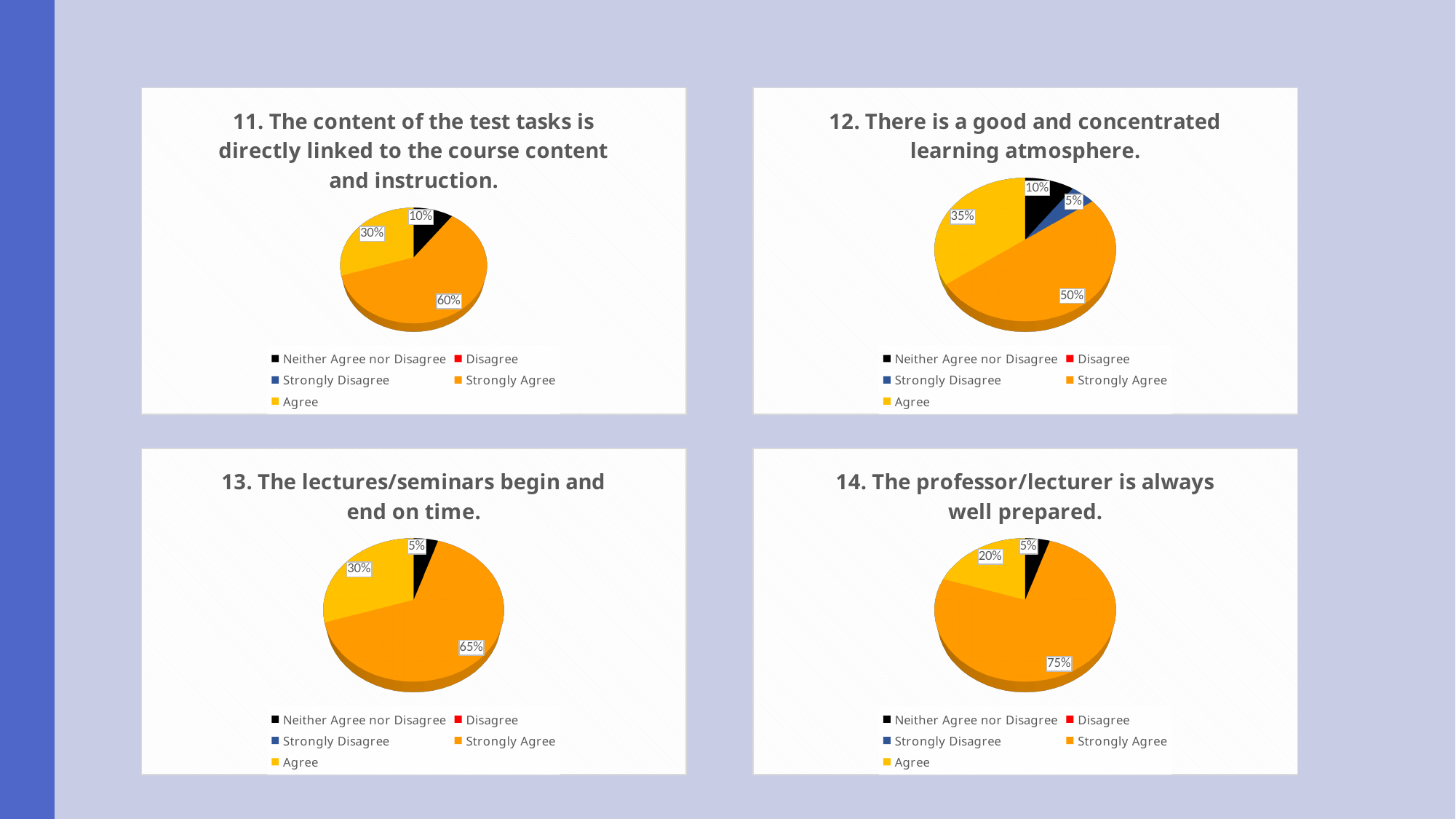
In the chart titled "14. The professor/lecturer is always well prepared.", is the Strongly Agree share larger or the Agree share larger? Strongly Agree What kind of chart is used for "13. The lectures/seminars begin and end on time."? Pie chart In the chart titled "12. There is a good and concentrated learning atmosphere.", what share of responses is Strongly Disagree? 5% In the chart titled "13. The lectures/seminars begin and end on time.", what share of responses is Strongly Agree? 65% In the chart titled "12. There is a good and concentrated learning atmosphere.", which response category has the largest share? Strongly Agree In the chart titled "12. There is a good and concentrated learning atmosphere.", how many slices have a data label shown? 4 In the chart titled "12. There is a good and concentrated learning atmosphere.", what is the difference between the Strongly Agree share and the Agree share? 15% In the chart titled "11. The content of the test tasks is directly linked to the course content and instruction.", what share of responses is Strongly Agree? 60% In the chart titled "11. The content of the test tasks is directly linked to the course content and instruction.", what share of responses is Agree? 30% How many entries does the legend list in the chart titled "11. The content of the test tasks is directly linked to the course content and instruction."? 5 In the chart titled "14. The professor/lecturer is always well prepared.", what share of responses is Agree? 20%